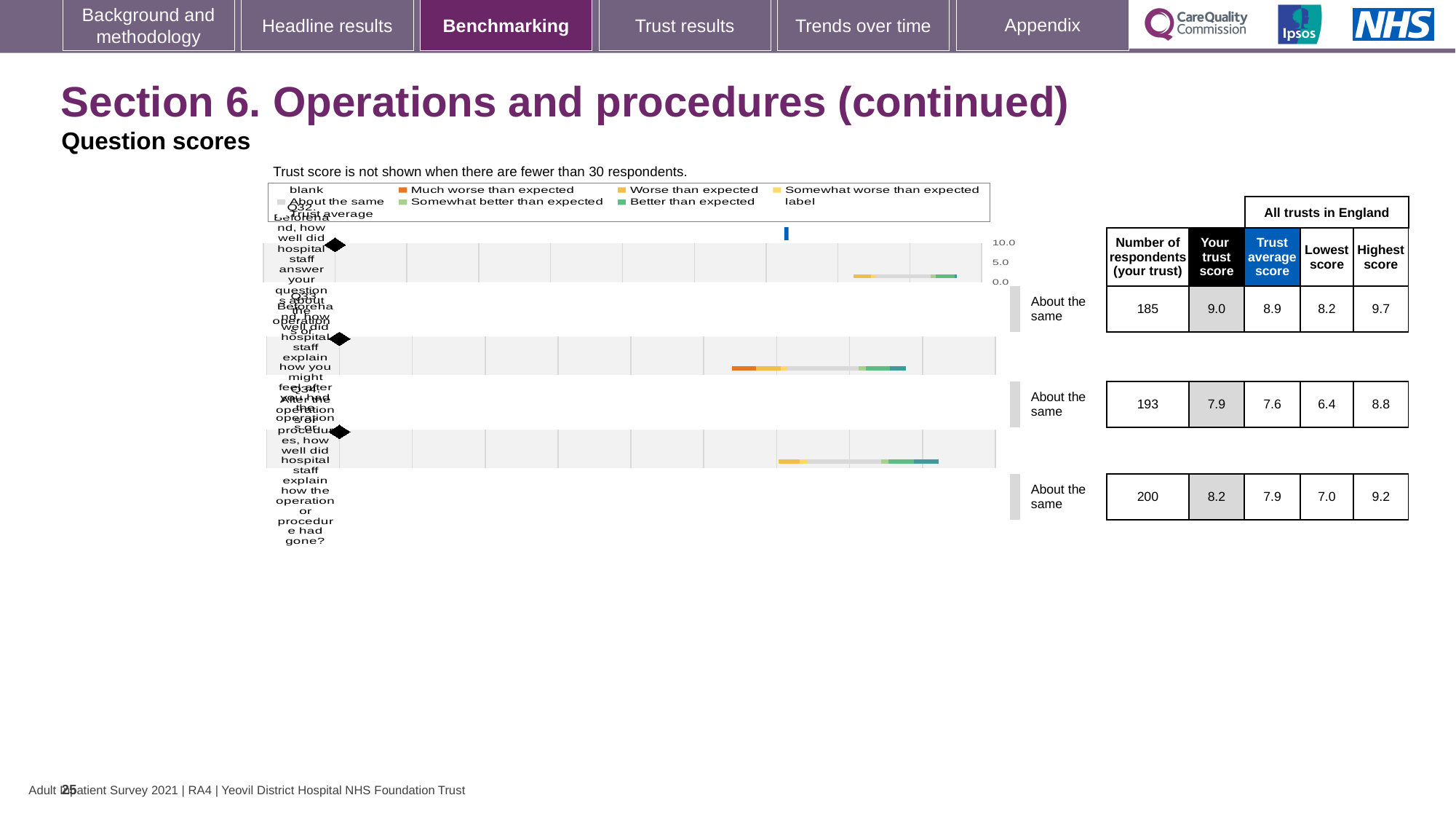
What is the 'Lowest score' for the second question row? 6.4 What is the 'Trust average score' for the first question row? 8.9 What is the 'Highest score' for the third question row? 9.2 In the table, how many respondents (your trust) are shown for the first question row? 185 For the third question row, what is the difference between 'Your trust score' and 'Trust average score'? 0.3 What benchmark category label is shown next to each of the three question rows? About the same Which question row has the lowest 'Lowest score'? The second row (6.4) How many respondents are shown for the third question row? 200 What is 'Your trust score' for the first question row in the table? 9.0 For the second question row, which is larger: 'Your trust score' or 'Trust average score'? Your trust score (7.9) How many question rows are shown in the chart and table? 3 Which question row has the highest 'Your trust score'? The first row (9.0)